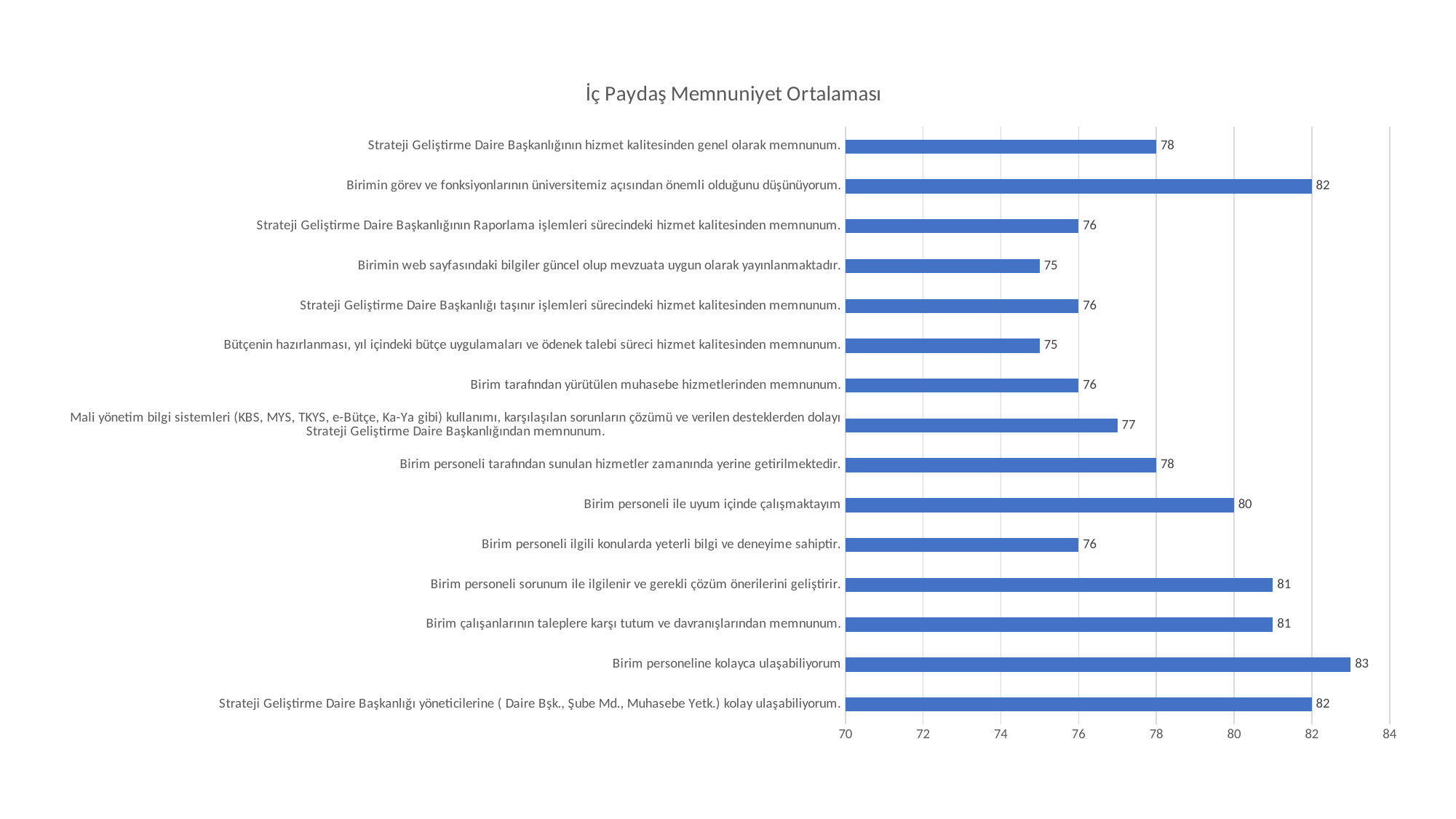
What is the difference between the value for "Birim personeline kolayca ulaşabiliyorum" and the value for "Birim personeli ilgili konularda yeterli bilgi ve deneyime sahiptir."? 7 Which category has the highest value? Birim personeline kolayca ulaşabiliyorum Which is larger: the value for "Birimin görev ve fonksiyonlarının üniversitemiz açısından önemli olduğunu düşünüyorum." or the value for "Birim personeli tarafından sunulan hizmetler zamanında yerine getirilmektedir."? Birimin görev ve fonksiyonlarının üniversitemiz açısından önemli olduğunu düşünüyorum. What is the value for "Birimin web sayfasındaki bilgiler güncel olup mevzuata uygun olarak yayınlanmaktadır."? 75 What is the value for "Birim personeli ile uyum içinde çalışmaktayım"? 80 Is the value for "Birim çalışanlarının taleplere karşı tutum ve davranışlarından memnunum." greater or less than 80? greater What is the lowest value shown in the chart? 75 What is the value for "Strateji Geliştirme Daire Başkanlığının hizmet kalitesinden genel olarak memnunum."? 78 What type of chart is shown on the slide? bar chart What is the title of the chart? İç Paydaş Memnuniyet Ortalaması What is the value for "Birim personeline kolayca ulaşabiliyorum"? 83 How many categories are plotted in the chart? 15